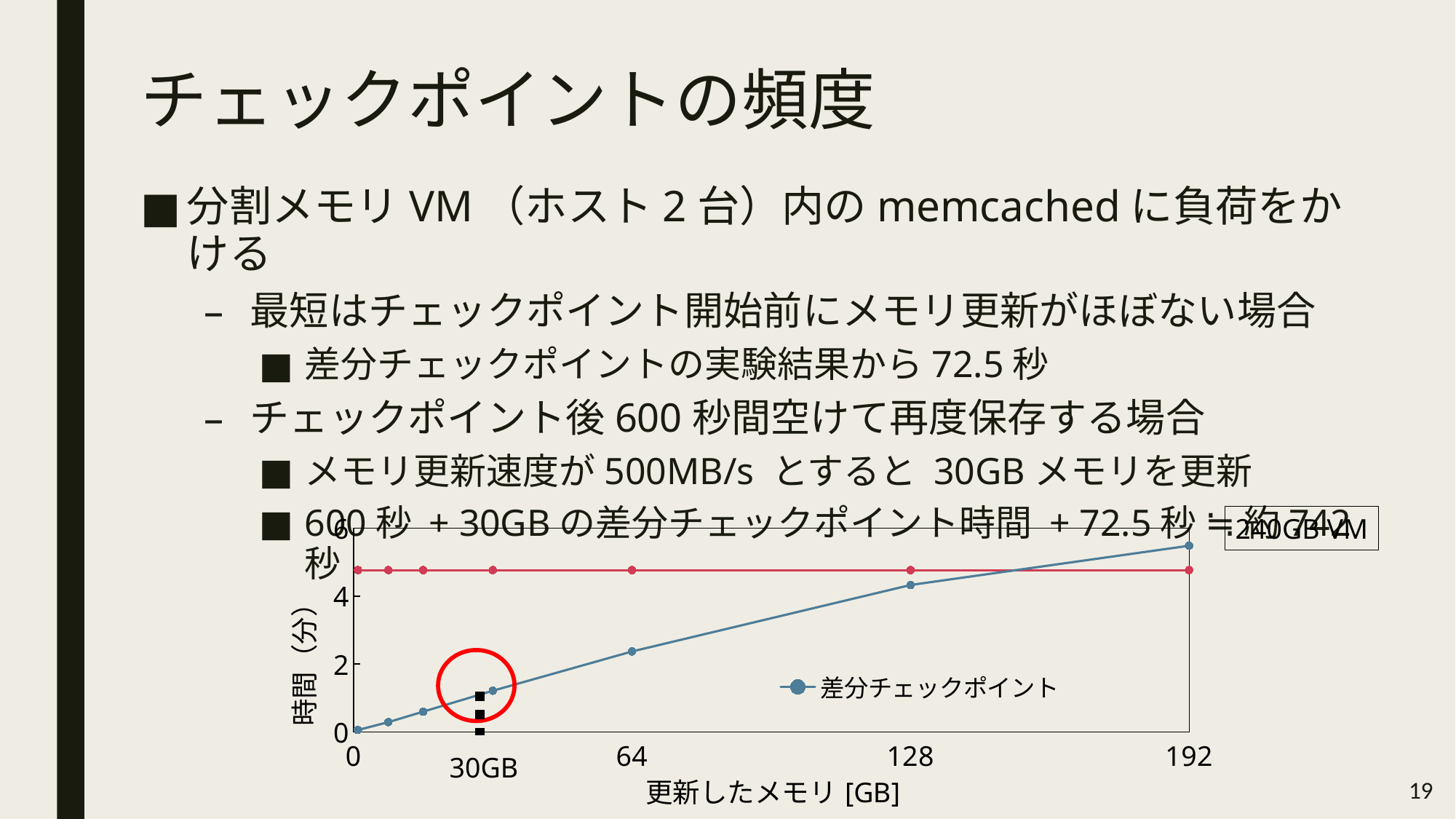
What is the title of the x axis of the chart? 更新したメモリ [GB] Is the 差分チェックポイント value at 192 GB greater or less than 6? less At 192 GB, which is higher: the 差分チェックポイント line or the red horizontal line? 差分チェックポイント Is the 差分チェックポイント value at 192 GB greater or less than 4? greater What kind of chart is shown on the slide? line chart What is the title of the y axis of the chart? 時間（分） Is the 差分チェックポイント value at 64 GB greater or less than 4? less At 64 GB, which is higher: the 差分チェックポイント line or the red horizontal line? the red horizontal line What is the largest value shown on the x axis of the chart? 192 Does the 差分チェックポイント line rise or fall as 更新したメモリ increases? rise How many data points are plotted on the 差分チェックポイント line? 7